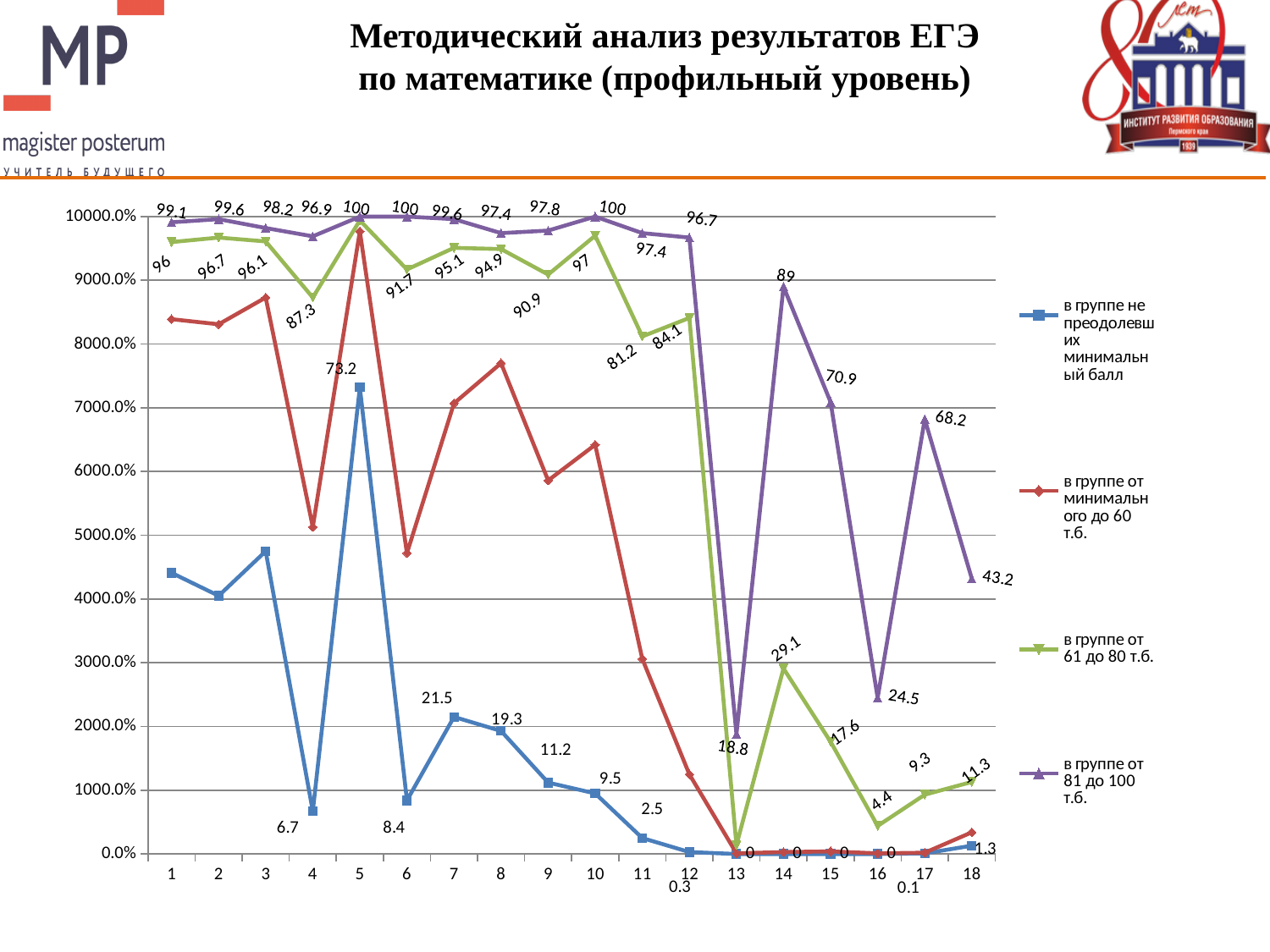
How many categories are shown along the x axis? 18 What is the value for category 4 in the series "в группе от 61 до 80 т.б."? 87.3 What is the value for category 14 in the series "в группе от 81 до 100 т.б."? 89 At category 14, what is the difference between the value for "в группе от 81 до 100 т.б." (89) and the value for "в группе от 61 до 80 т.б." (29.1)? 59.9 Is the value for category 9 in the series "в группе от минимального до 60 т.б." greater or less than 5000.0%? greater Which category has the highest value in the series "в группе не преодолевших минимальный балл"? 5 What is the value for category 18 in the series "в группе от 81 до 100 т.б."? 43.2 What kind of chart is shown on the slide? line chart How many series does the legend list? 4 Which category has the lowest value in the series "в группе от 81 до 100 т.б."? 13 What is the value for category 5 in the series "в группе не преодолевших минимальный балл"? 73.2 At category 14, which series has the larger value: "в группе от 81 до 100 т.б." or "в группе от 61 до 80 т.б."? в группе от 81 до 100 т.б.